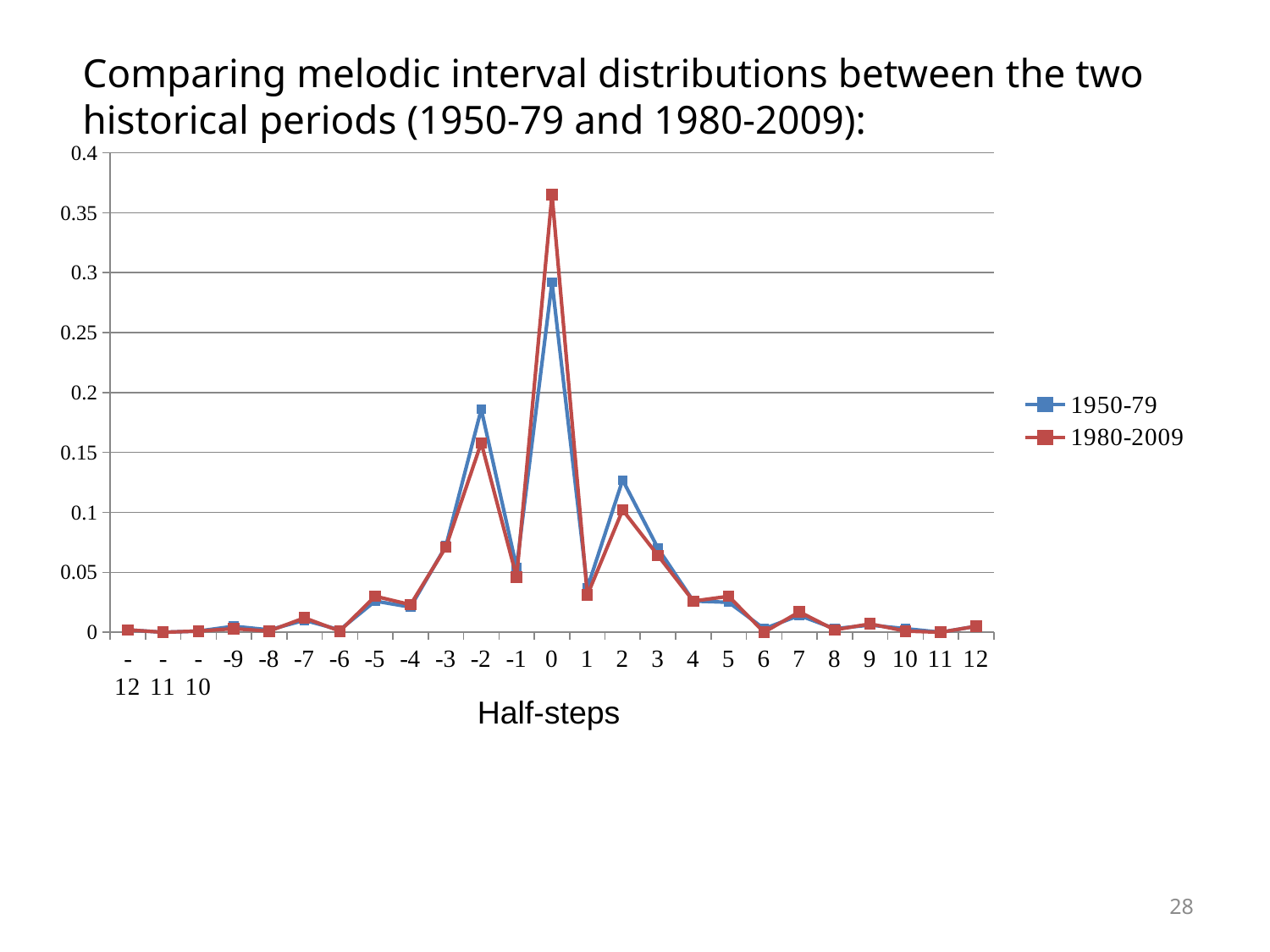
At which half-step value does the 1980-2009 series reach its highest point? 0 At half-step -2, which series has the larger value, 1950-79 or 1980-2009? 1950-79 How many half-step categories are plotted along the x axis? 25 At half-step 0, which series has the larger value, 1950-79 or 1980-2009? 1980-2009 What kind of chart is shown on the slide? line chart Is the value for the 1950-79 series at half-step -2 greater or less than 0.15? greater Is the value for the 1980-2009 series at half-step 0 greater or less than 0.3? greater Is the value for the 1980-2009 series at half-step 2 greater or less than 0.15? less At which half-step value does the 1950-79 series reach its highest point? 0 What is the label of the x axis? Half-steps How many series does the legend list? 2 At half-step 2, which series has the larger value, 1950-79 or 1980-2009? 1950-79